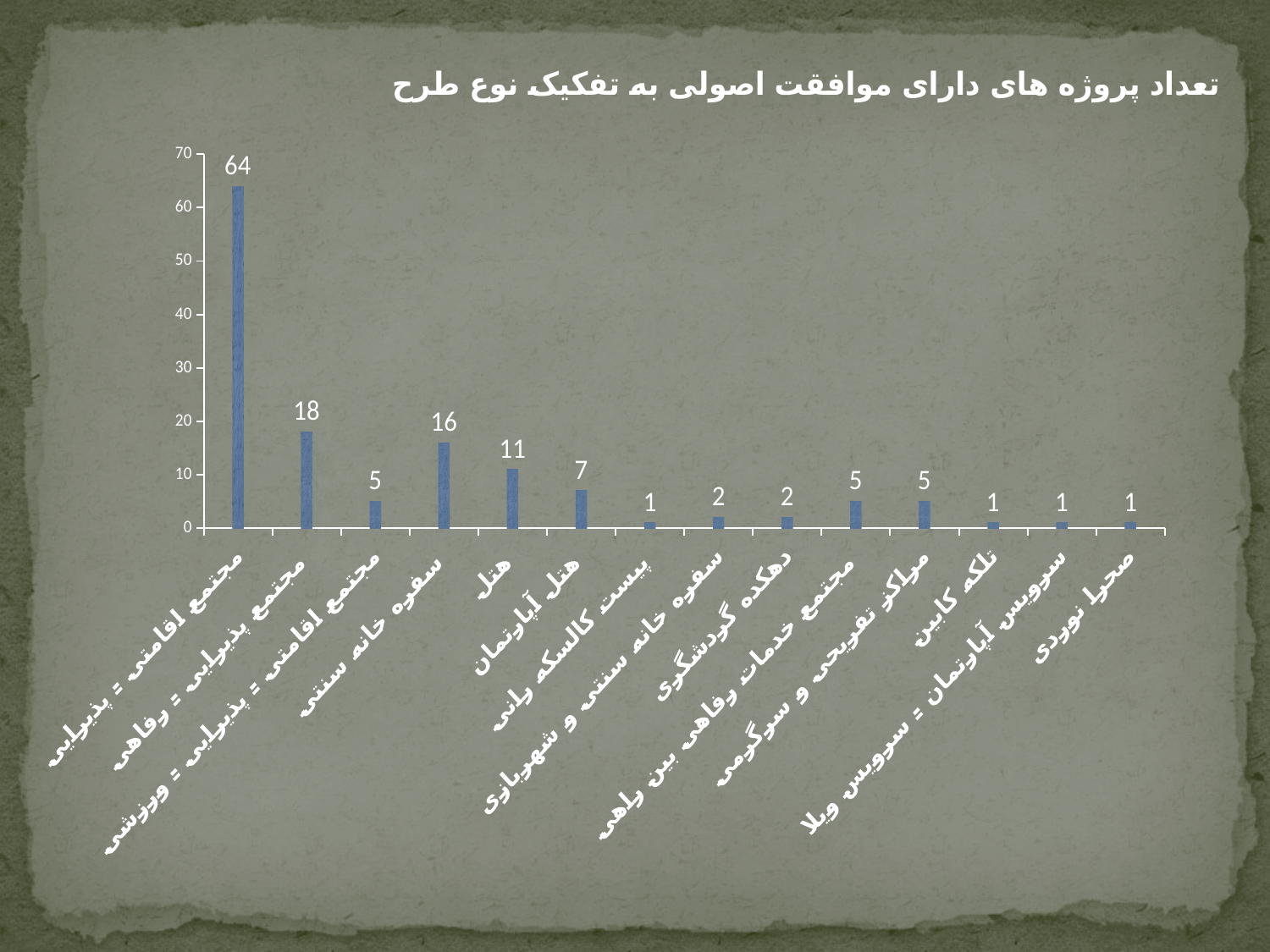
What is the difference between the values for مجتمع اقامتی - پذیرایی and مجتمع پذیرایی - رفاهی? 46 Which category has the highest value? مجتمع اقامتی - پذیرایی What is the difference between the values for سفره خانه سنتی and هتل? 5 What is the title of the chart? تعداد پروژه های دارای موافقت اصولی به تفکیک نوع طرح What is the value for دهکده گردشگری? 2 How many categories are shown on the x axis? 14 What kind of chart is shown on the slide? bar chart What is the value for سفره خانه سنتی? 16 Which is larger, the value for هتل or the value for هتل آپارتمان? هتل What is the value for هتل آپارتمان? 7 Is the value for مجتمع اقامتی - پذیرایی greater or less than 60? greater What is the value for هتل? 11